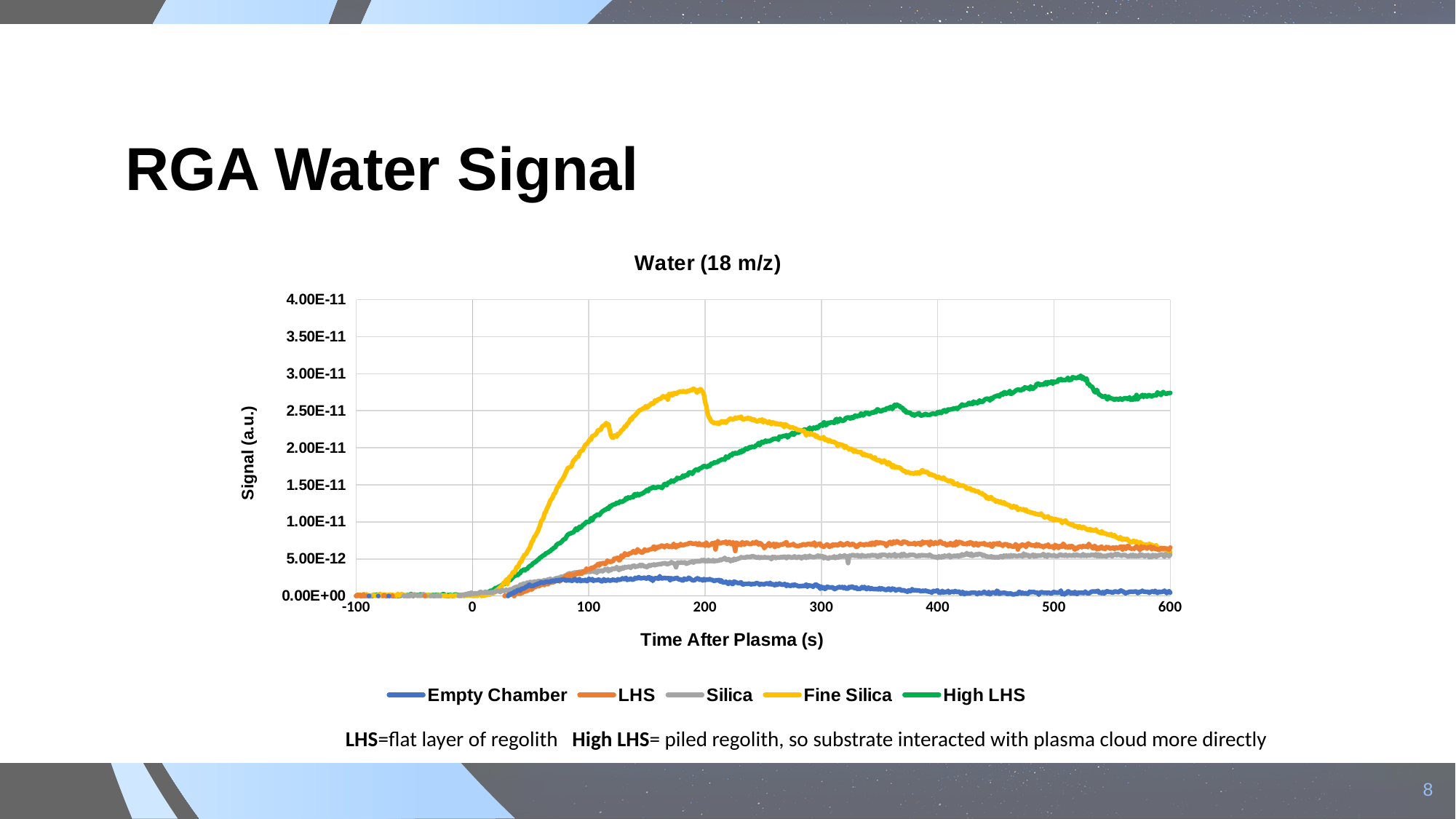
At 100 s, which series has the larger value, Fine Silica or High LHS? Fine Silica How many series does the legend list? 5 At 600 s, which series has the larger value, High LHS or Fine Silica? High LHS What is the label of the x axis? Time After Plasma (s) What kind of chart is shown on the slide? line chart Is the value for LHS at 400 s greater or less than 1.00E-11? less Which series has the lowest value at 600 s? Empty Chamber What is the title of the chart? Water (18 m/z) Is the value for Fine Silica at 600 s greater or less than 1.00E-11? less Is the value for High LHS at 500 s greater or less than 2.50E-11? greater Does the Fine Silica signal rise or fall between 200 s and 600 s? fall